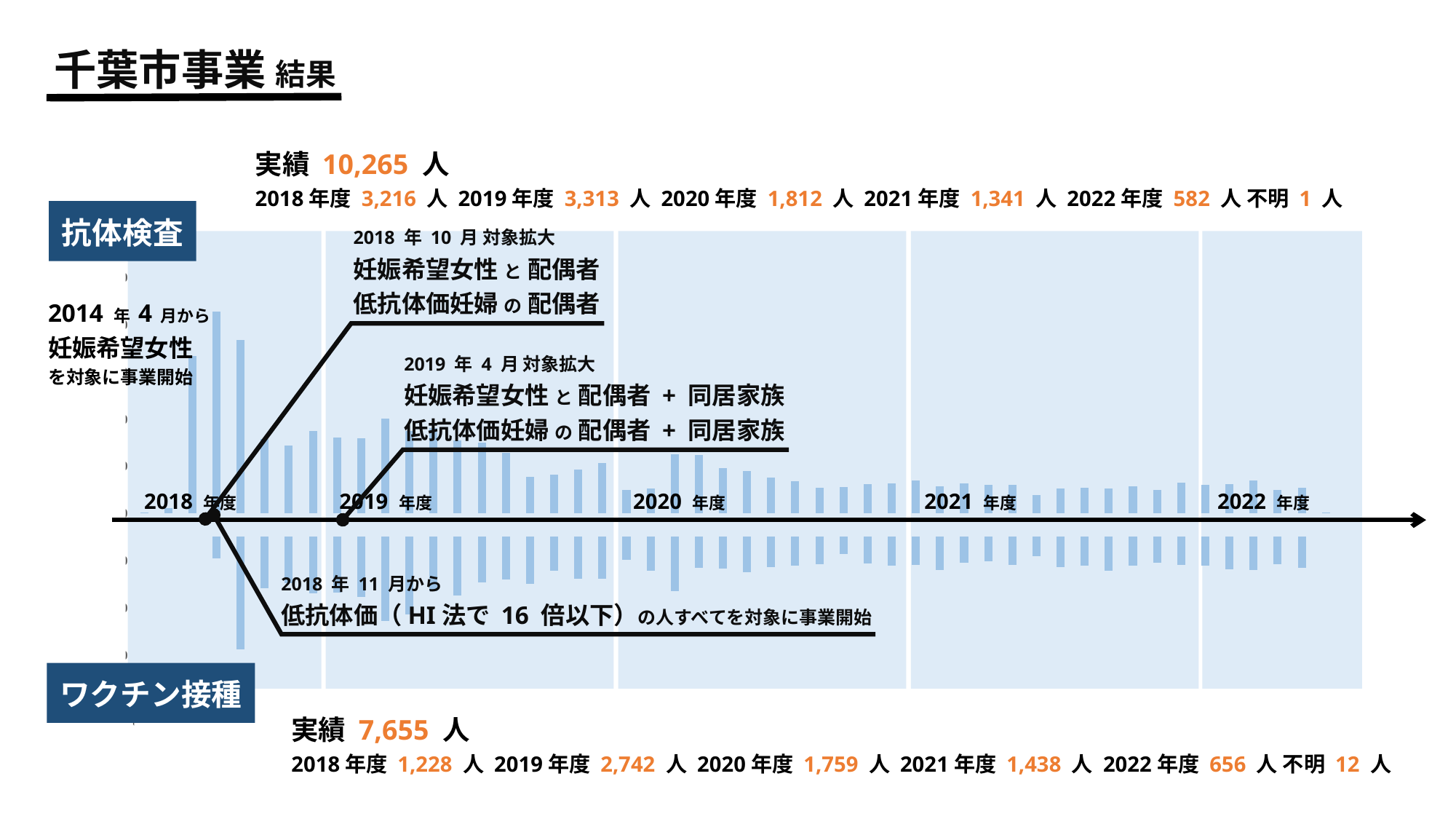
How many fiscal years are labelled along the horizontal axis of the chart? 5 What is the difference between the 抗体検査 counts for 2018 年度 and 2022 年度? 2,634 人 What is the total number of people (実績) for ワクチン接種 shown on the slide? 7,655 人 Which fiscal year has the lowest number of ワクチン接種? 2022 年度 How many people received ワクチン接種 in 2019 年度? 2,742 人 Do the 抗体検査 bars above the axis generally rise or fall from 2018 年度 to 2022 年度? Fall What is the title of the slide? 千葉市事業 結果 What is the total number of people (実績) for 抗体検査 shown on the slide? 10,265 人 Which is larger in 2021 年度: the 抗体検査 count or the ワクチン接種 count? ワクチン接種 (1,438 人) How many people received 抗体検査 in 2020 年度? 1,812 人 Which fiscal year has the highest number of 抗体検査? 2019 年度 What kind of chart is used to show the monthly 抗体検査 and ワクチン接種 figures? Bar chart